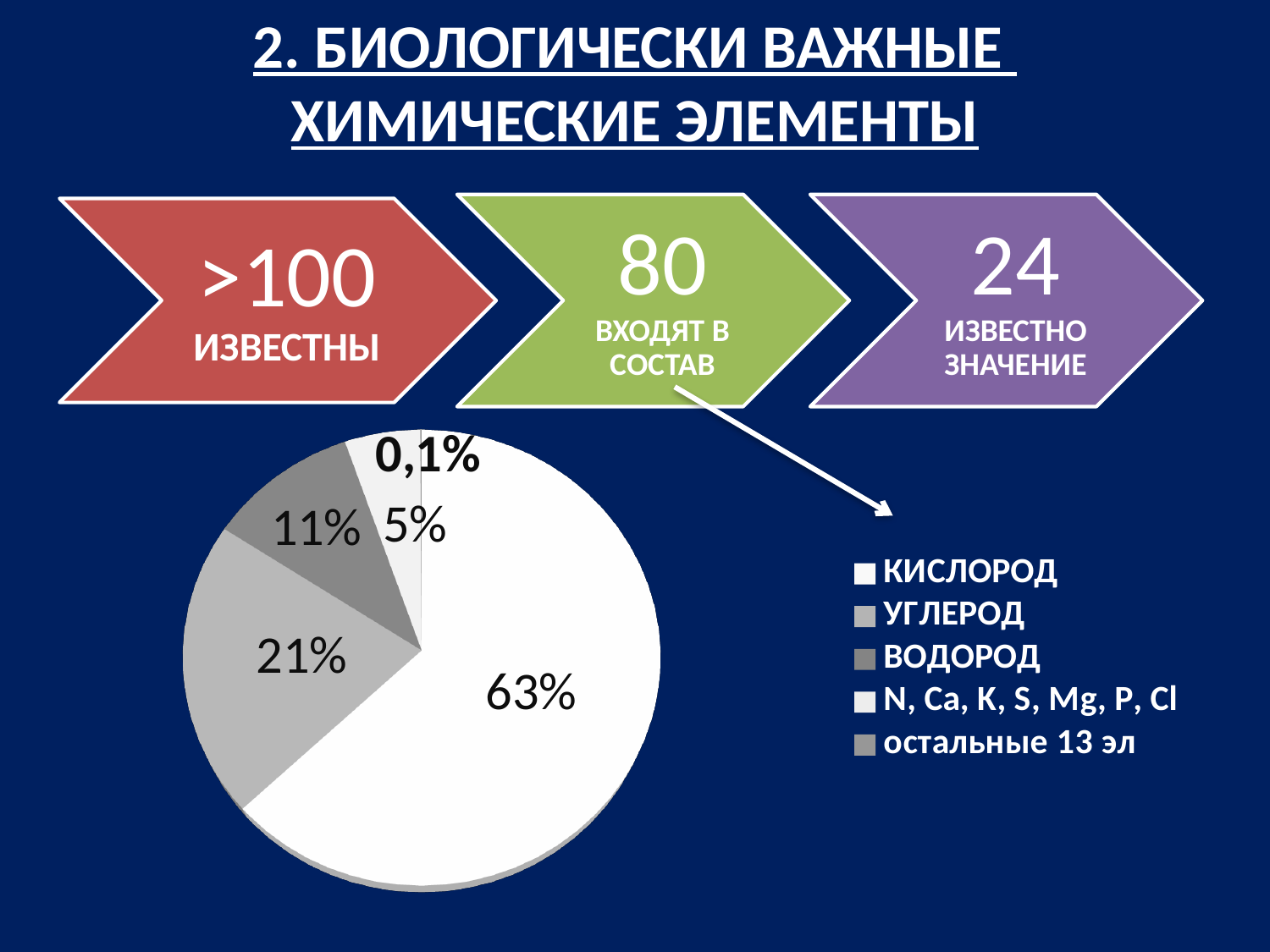
How many entries does the legend of the pie chart list? 5 What share of the pie does the slice for N, Ca, K, S, Mg, P, Cl have? 5% Which slice of the pie chart is the smallest? остальные 13 эл Which is larger, the share of ВОДОРОД or the share of N, Ca, K, S, Mg, P, Cl? ВОДОРОД What share of the pie does остальные 13 эл have? 0,1% What is the difference between the shares of КИСЛОРОД and УГЛЕРОД? 42% What kind of chart is shown on the slide? pie chart Which slice of the pie chart is the largest? КИСЛОРОД What share of the pie does ВОДОРОД have? 11% How many slices does the pie chart have? 5